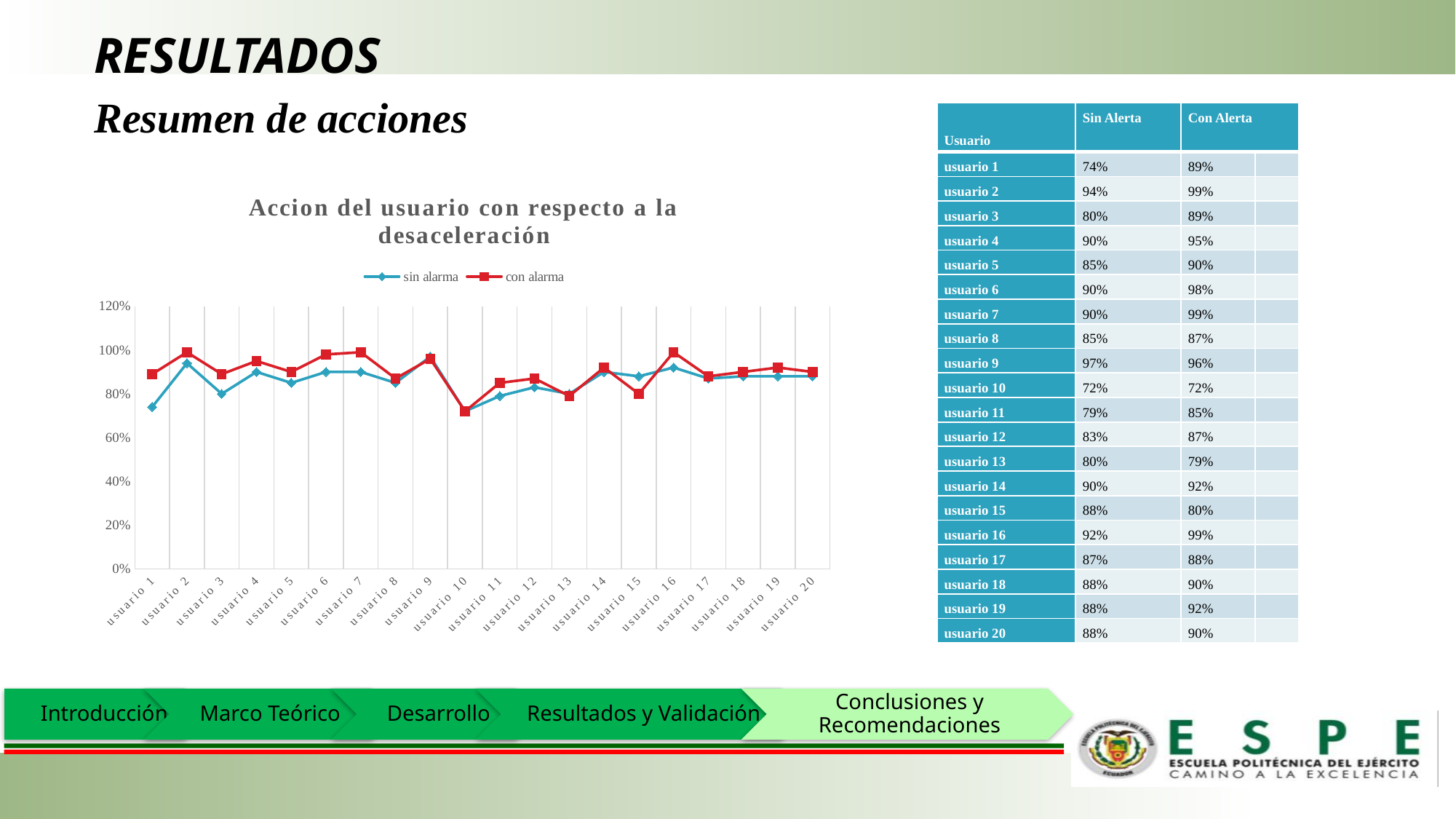
Is the 'sin alarma' value for usuario 10 greater or less than 80%? less What is the 'con alarma' value for usuario 2? 99% What is the title of the chart? Accion del usuario con respecto a la desaceleración For usuario 1, what is the difference between the 'con alarma' and 'sin alarma' values? 15% For usuario 15, which is larger: the 'sin alarma' value or the 'con alarma' value? sin alarma What kind of chart is shown on the slide? line chart Which series is drawn in red with square markers? con alarma What is the 'sin alarma' value for usuario 1? 74% How many series does the legend of the chart list? 2 Which user has the lowest 'con alarma' value? usuario 10 Which user has the highest 'sin alarma' value? usuario 9 How many users (categories) are plotted along the x axis of the chart? 20